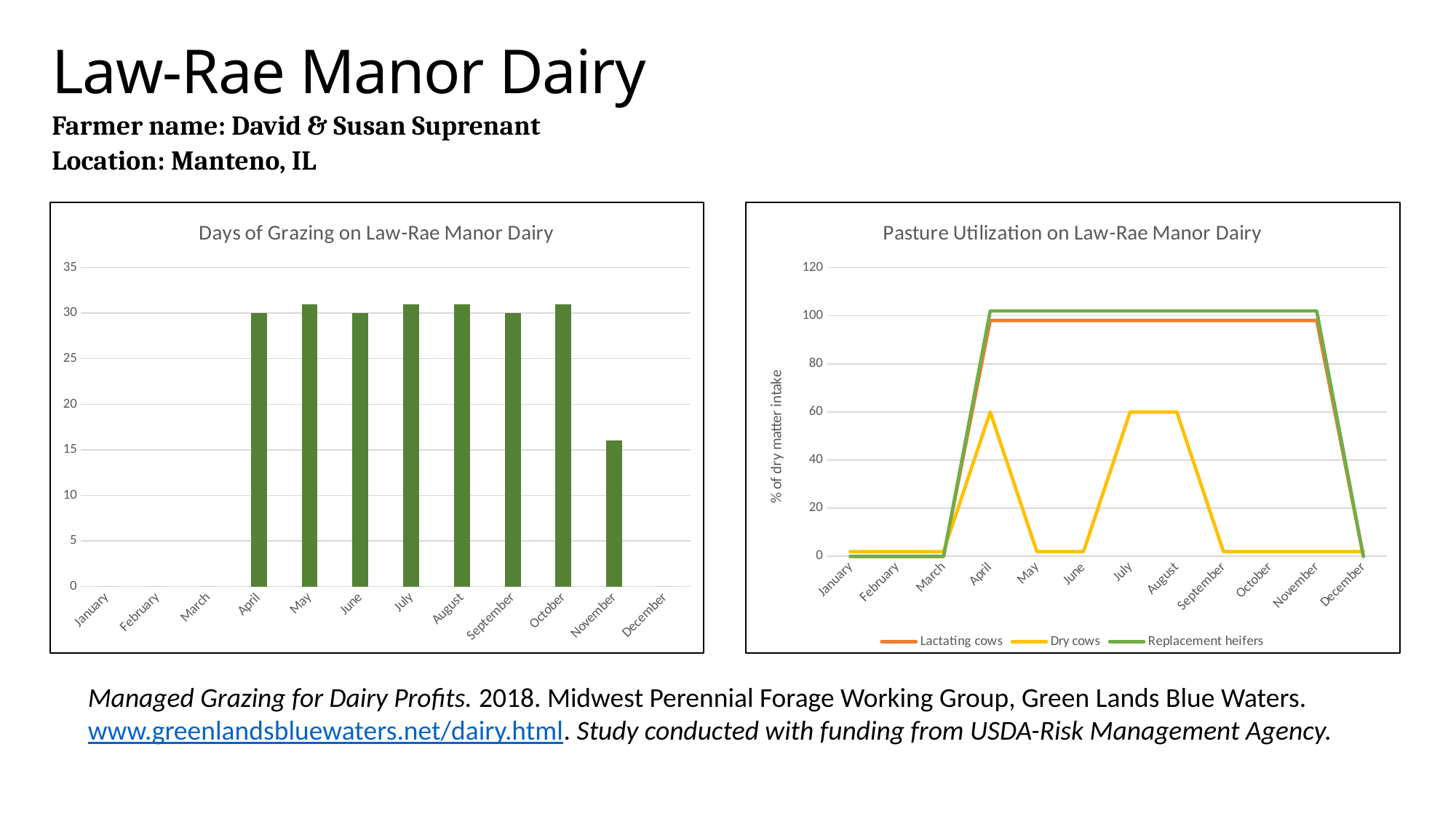
In the 'Days of Grazing on Law-Rae Manor Dairy' chart, which is larger, the value for October or the value for November? October What is the y-axis label of the 'Pasture Utilization on Law-Rae Manor Dairy' chart? % of dry matter intake In the 'Pasture Utilization on Law-Rae Manor Dairy' chart, which is larger in June, Replacement heifers or Dry cows? Replacement heifers In the 'Pasture Utilization on Law-Rae Manor Dairy' chart, is the value for Lactating cows in June greater or less than 80? greater How many series does the legend of the 'Pasture Utilization on Law-Rae Manor Dairy' chart list? 3 What type of chart is the 'Days of Grazing on Law-Rae Manor Dairy' chart? bar chart In the 'Pasture Utilization on Law-Rae Manor Dairy' chart, what is the value for Dry cows in April? 60 What type of chart is the 'Pasture Utilization on Law-Rae Manor Dairy' chart? line chart In the 'Days of Grazing on Law-Rae Manor Dairy' chart, how many months have a visible bar? 8 In the 'Days of Grazing on Law-Rae Manor Dairy' chart, is the value for November greater or less than 15? greater In the 'Days of Grazing on Law-Rae Manor Dairy' chart, is the value for May greater or less than 25? greater